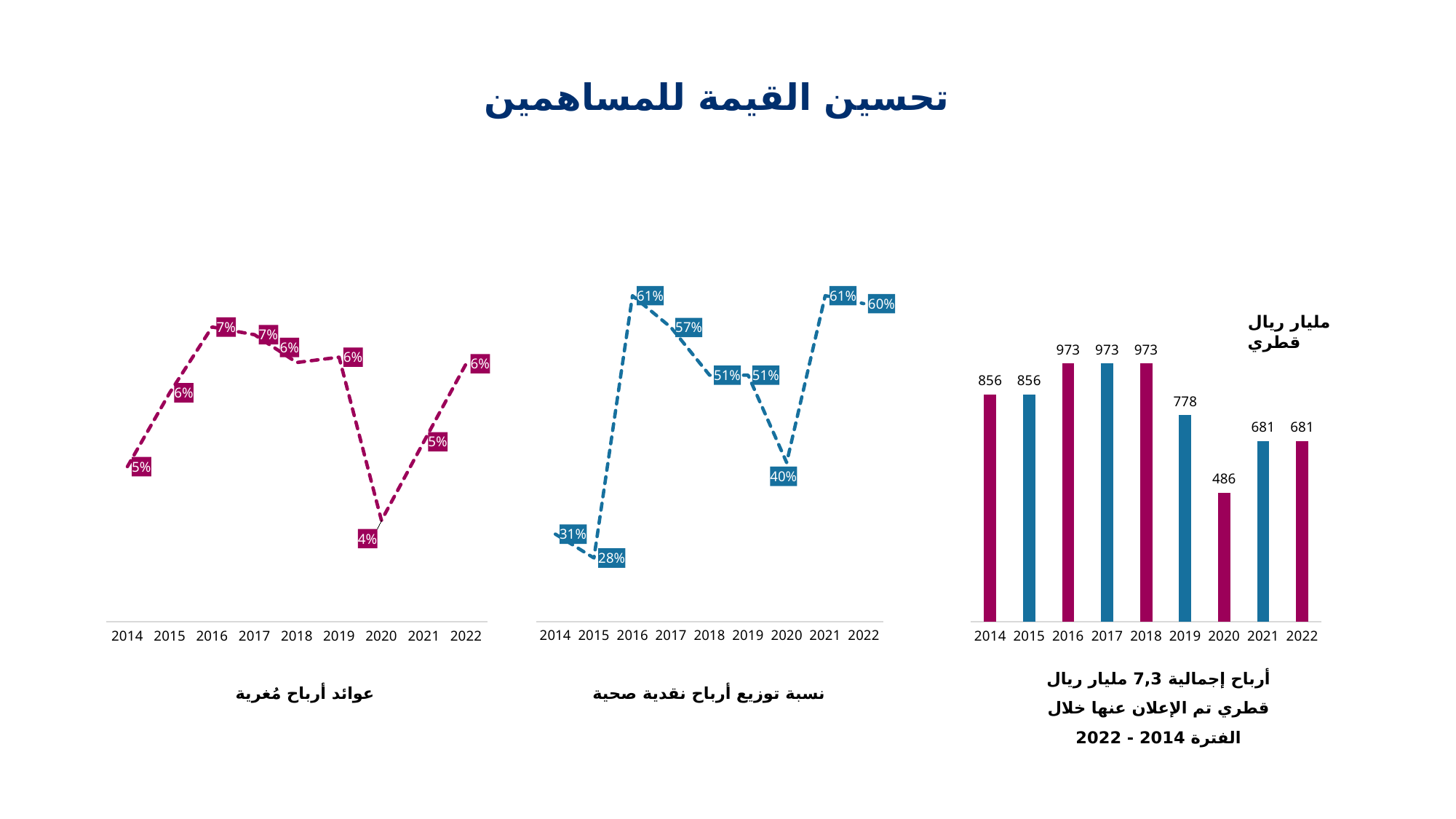
How many years are shown on the x axis of the right bar chart? 9 In the left line chart, what is the value for 2020? 4% In the middle line chart, is the value for 2017 larger or smaller than the value for 2020? larger In the middle line chart, which year has the lowest value? 2015 In the right bar chart, what is the value for 2019? 778 In the right bar chart, what is the difference between the values for 2018 and 2020? 487 In the left line chart, what is the value for 2016? 7% What kind of chart is the chart on the right of the slide? bar chart In the middle line chart, what is the value for 2015? 28% In the left line chart, which year has the lowest value? 2020 In the right bar chart, which year has the lowest value? 2020 In the middle line chart, what is the difference between the values for 2016 and 2020? 21%